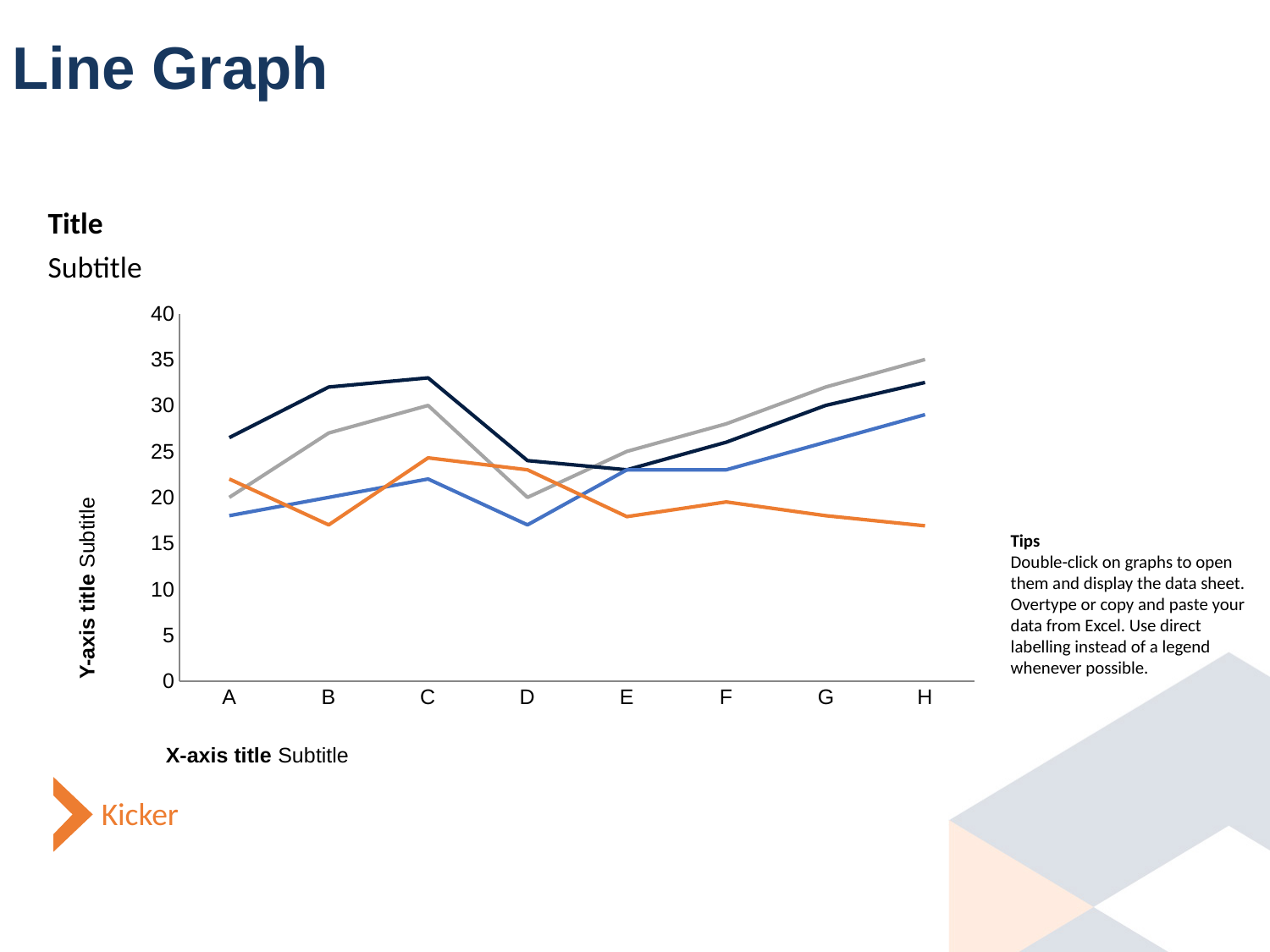
What is the highest value shown on the y axis of the chart? 40 How many categories are shown on the x axis of the chart? 8 Is the value of the dark navy line at category C greater or less than 30? greater Is the value of the grey line at category H greater or less than 30? greater At which category does the blue line reach its highest value? H Is the value of the orange line at category H greater or less than 20? less At category H, which line has the larger value, the grey line or the orange line? grey line At which category does the grey line reach its highest value? H What kind of chart is shown on the slide? line chart Does the grey line rise or fall from category D to category H? rise